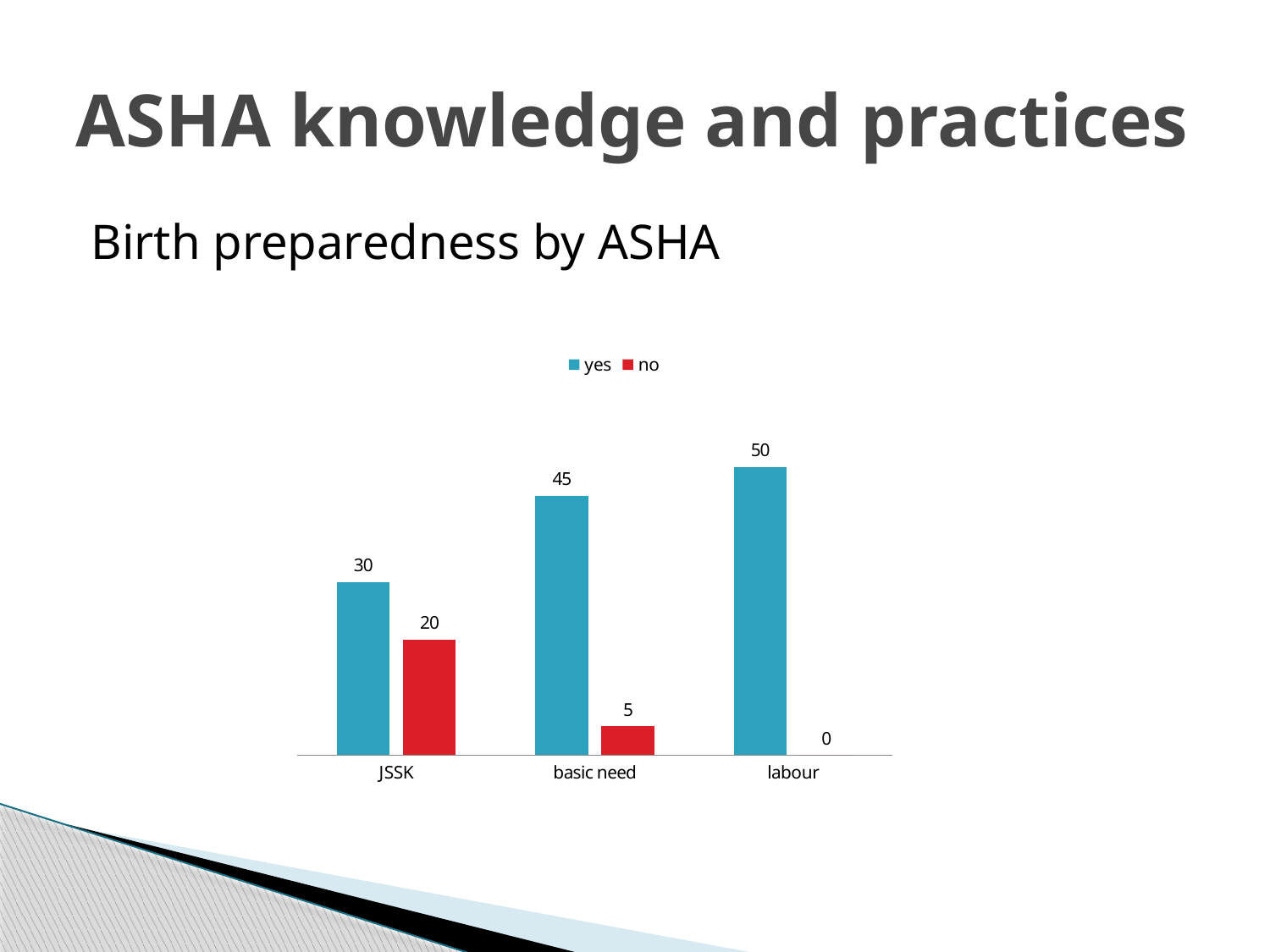
What is the 'yes' value for JSSK? 30 What is the 'no' value for labour? 0 How many categories are shown on the x axis? 3 What is the 'no' value for basic need? 5 What is the difference between the 'yes' and 'no' values for JSSK? 10 What is the difference between the 'yes' values for labour and basic need? 5 How many series does the legend list? 2 Which is larger, the 'no' value for JSSK or the 'no' value for basic need? JSSK What kind of chart is shown on the slide? bar chart Which category has the lowest 'no' value? labour Which colour represents the 'no' series? red Which category has the highest 'yes' value? labour